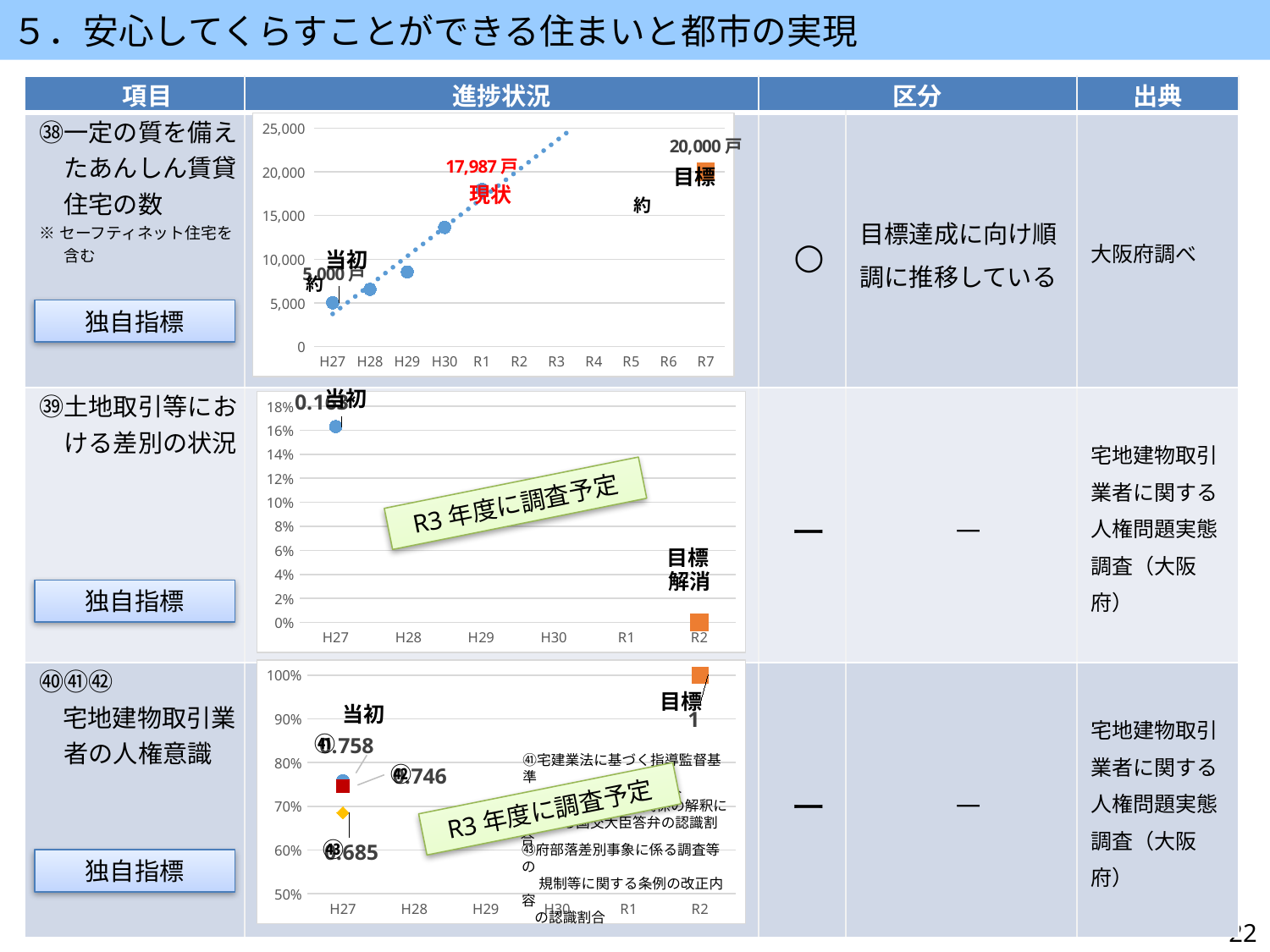
In the top chart, what is the 目標 value shown? 約20,000戸 In the top chart, which is larger, the 現状 value or the 目標 value? 目標 In the middle chart (土地取引等における差別の状況), is the value for H27 greater or less than 10%? greater In the top chart, what is the 当初 value shown for H27? 約5,000戸 In the top chart, is the value for H30 greater or less than 10,000? greater In the bottom chart (宅地建物取引業者の人権意識), what is the 目標 value shown at R2? 1 In the top chart (一定の質を備えたあんしん賃貸住宅の数), what is the 現状 value shown for R1? 17,987戸 In the top chart, is the value for H28 greater or less than 10,000? less In the middle chart, what is the 目標 label shown at R2? 解消 In the top chart, do the plotted values rise or fall from H27 to R1? rise In the top chart, how many categories are on the x axis? 11 In the bottom chart, which is larger at H27, the value for ㊶ (0.758) or the value for ㊸ (0.685)? ㊶